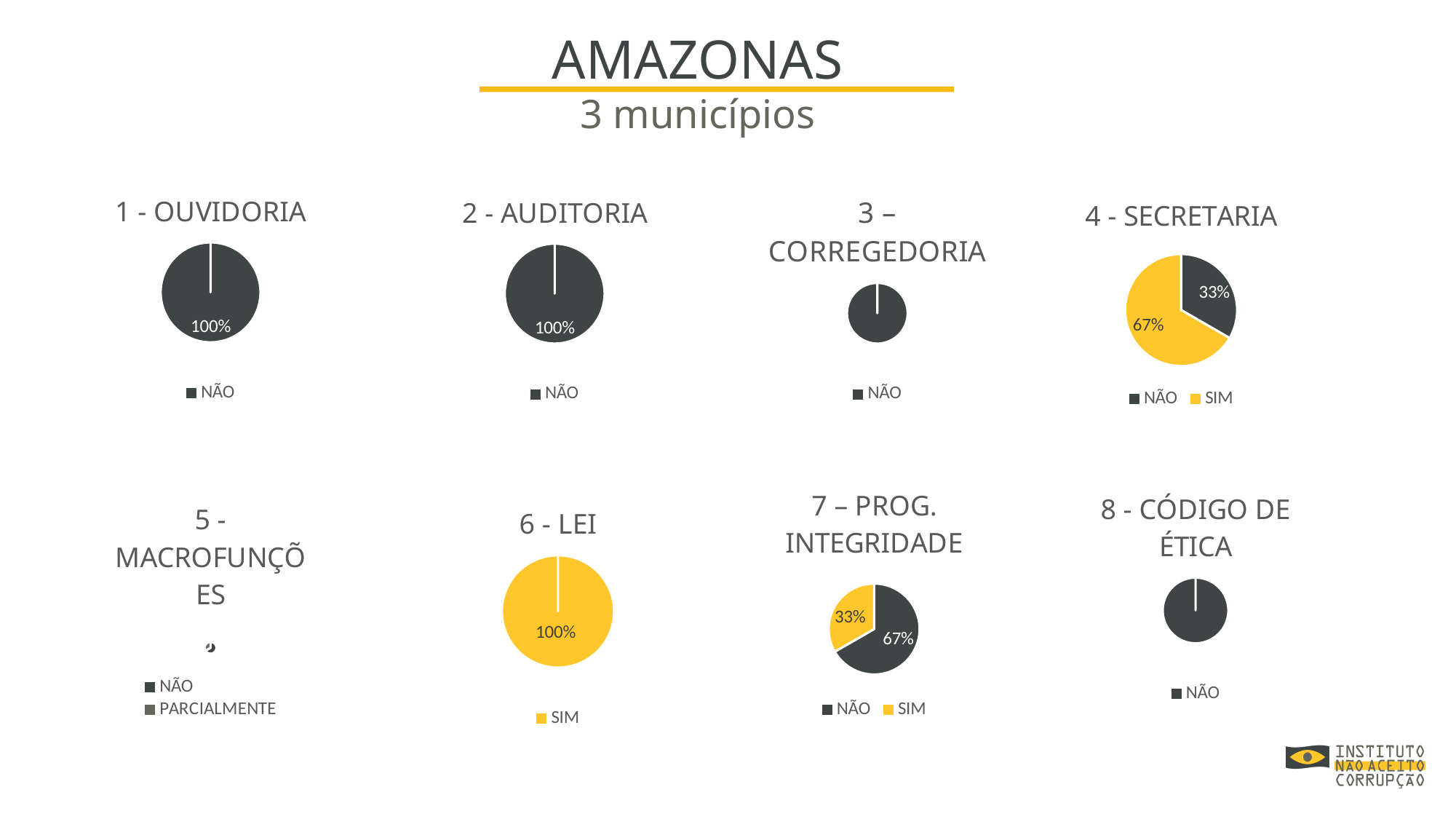
In the "7 – PROG. INTEGRIDADE" chart, what share of the pie is labelled SIM? 33% In the "1 - OUVIDORIA" chart, what percentage is shown for NÃO? 100% In the "7 – PROG. INTEGRIDADE" chart, what share of the pie is labelled NÃO? 67% What are the two legend entries of the "5 - MACROFUNÇÕES" chart? NÃO and PARCIALMENTE How many entries does the legend of the "4 - SECRETARIA" chart list? 2 How many entries does the legend of the "2 - AUDITORIA" chart list? 1 In the "4 - SECRETARIA" chart, which slice is larger, SIM or NÃO? SIM What kind of chart is used for "6 - LEI"? Pie chart In the "6 - LEI" chart, what percentage is shown for SIM? 100% In the "7 – PROG. INTEGRIDADE" chart, which slice is larger, SIM or NÃO? NÃO In the "4 - SECRETARIA" chart, what share of the pie is labelled SIM? 67%